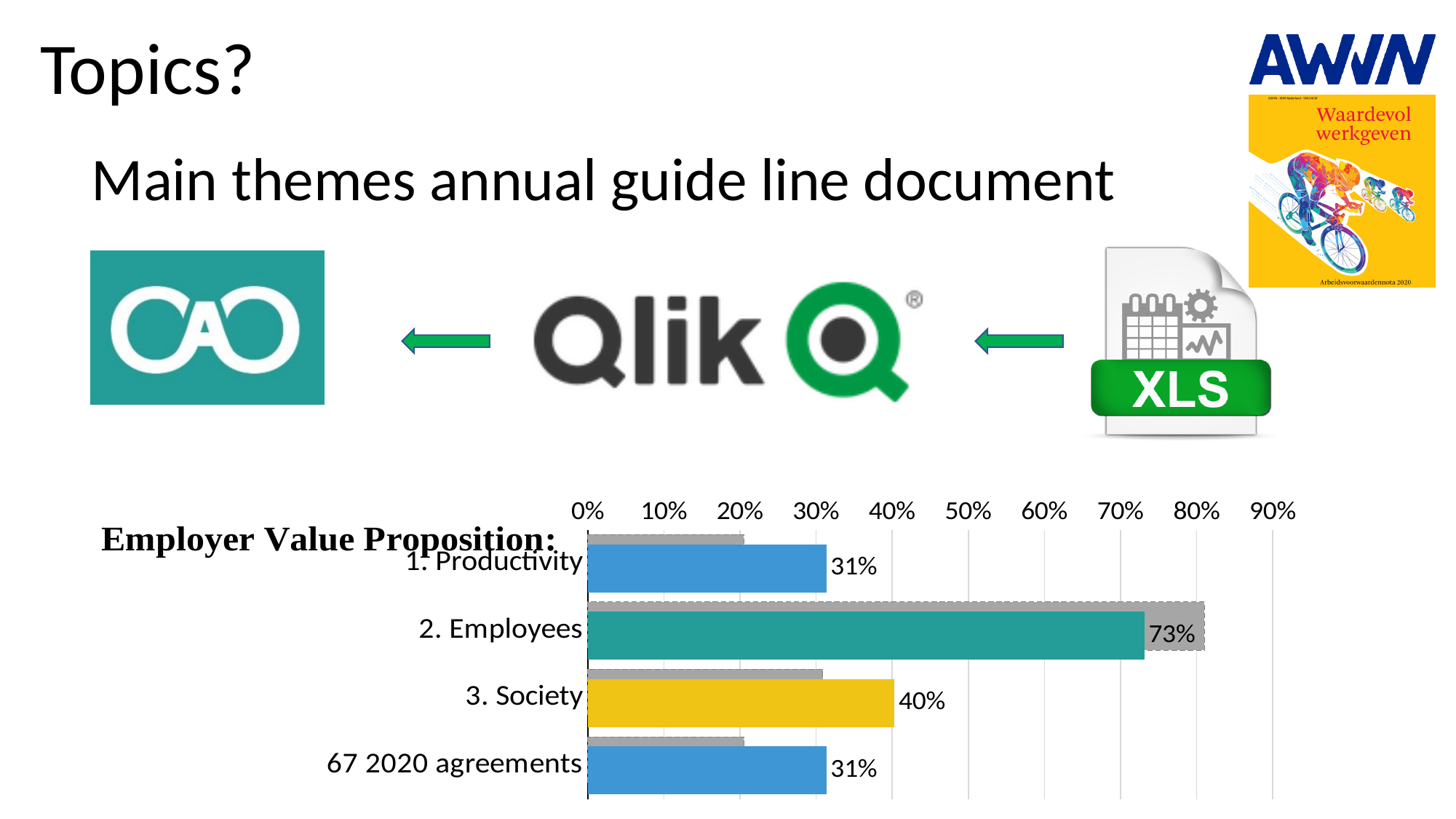
What is the value shown for 67 2020 agreements? 31% What is the difference between the values for 2. Employees and 3. Society? 33% What is the value shown for 2. Employees? 73% What is the highest percentage tick shown on the chart's axis? 90% Which category has the highest labelled value? 2. Employees Is the value for 2. Employees greater or less than 70%? greater Which is larger, the value for 3. Society or the value for 1. Productivity? 3. Society What is the value shown for 1. Productivity? 31% How many categories are shown on the chart? 4 What is the difference between the values for 3. Society and 1. Productivity? 9% What kind of chart is shown at the bottom of the slide? bar chart What is the value shown for 3. Society? 40%